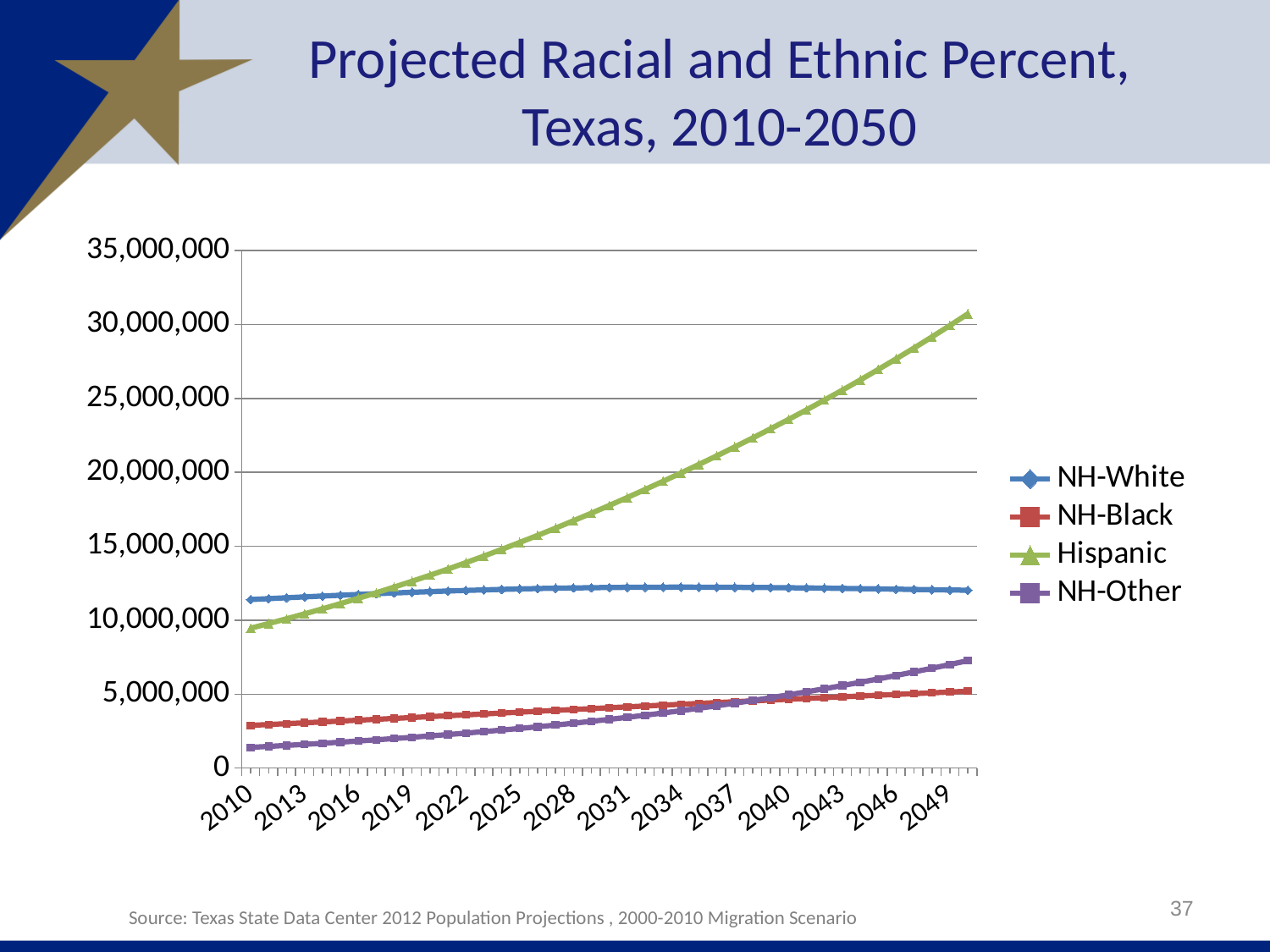
What kind of chart is shown on the slide? line chart Is the value for NH-White in 2010 greater or less than 10,000,000? greater Is the value for NH-Black in 2010 greater or less than 5,000,000? less Does the NH-Other series rise or fall from 2010 to 2050? rise In 2010, which is larger: NH-White or Hispanic? NH-White What colour is the Hispanic line in the legend? green Does the Hispanic series rise or fall from 2010 to 2050? rise In 2050, which is larger: NH-Black or NH-Other? NH-Other How many series does the legend list? 4 Which series has the lowest value in 2010? NH-Other Is the value for Hispanic in 2050 greater or less than 25,000,000? greater Which series has the highest value in 2050? Hispanic